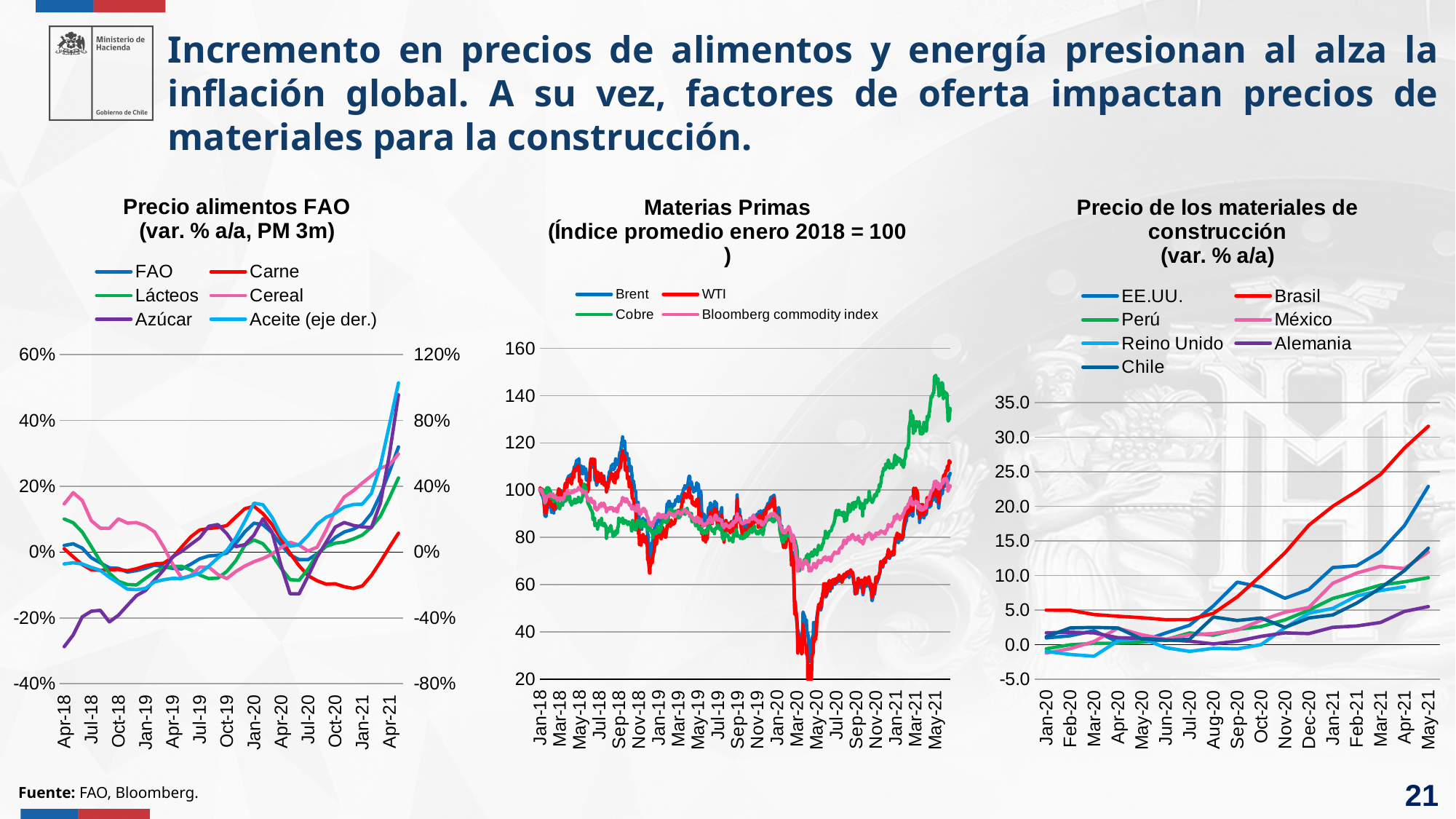
In the 'Precio de los materiales de construcción' chart, does the Brasil series rise or fall from Jul-20 to May-21? rise How many series does the legend of the 'Precio de los materiales de construcción' chart list? 7 In the 'Materias Primas' chart, which series is highest at May-21? Cobre What kind of chart is the 'Materias Primas' chart? line chart How many series does the legend of the 'Materias Primas' chart list? 4 In the 'Materias Primas' chart, which series falls lowest around Apr-20? WTI In the 'Precio de los materiales de construcción' chart, is the value for Brasil at May-21 greater or less than 25.0? greater What is the base period of the index in the 'Materias Primas' chart, according to its title? promedio enero 2018 = 100 In the 'Precio alimentos FAO' chart, which series is plotted on the right-hand axis? Aceite (eje der.) How many series does the legend of the 'Precio alimentos FAO' chart list? 6 In the 'Materias Primas' chart, is the value of Cobre at May-21 greater or less than 120? greater In the 'Precio de los materiales de construcción' chart, which country has the highest value at May-21? Brasil